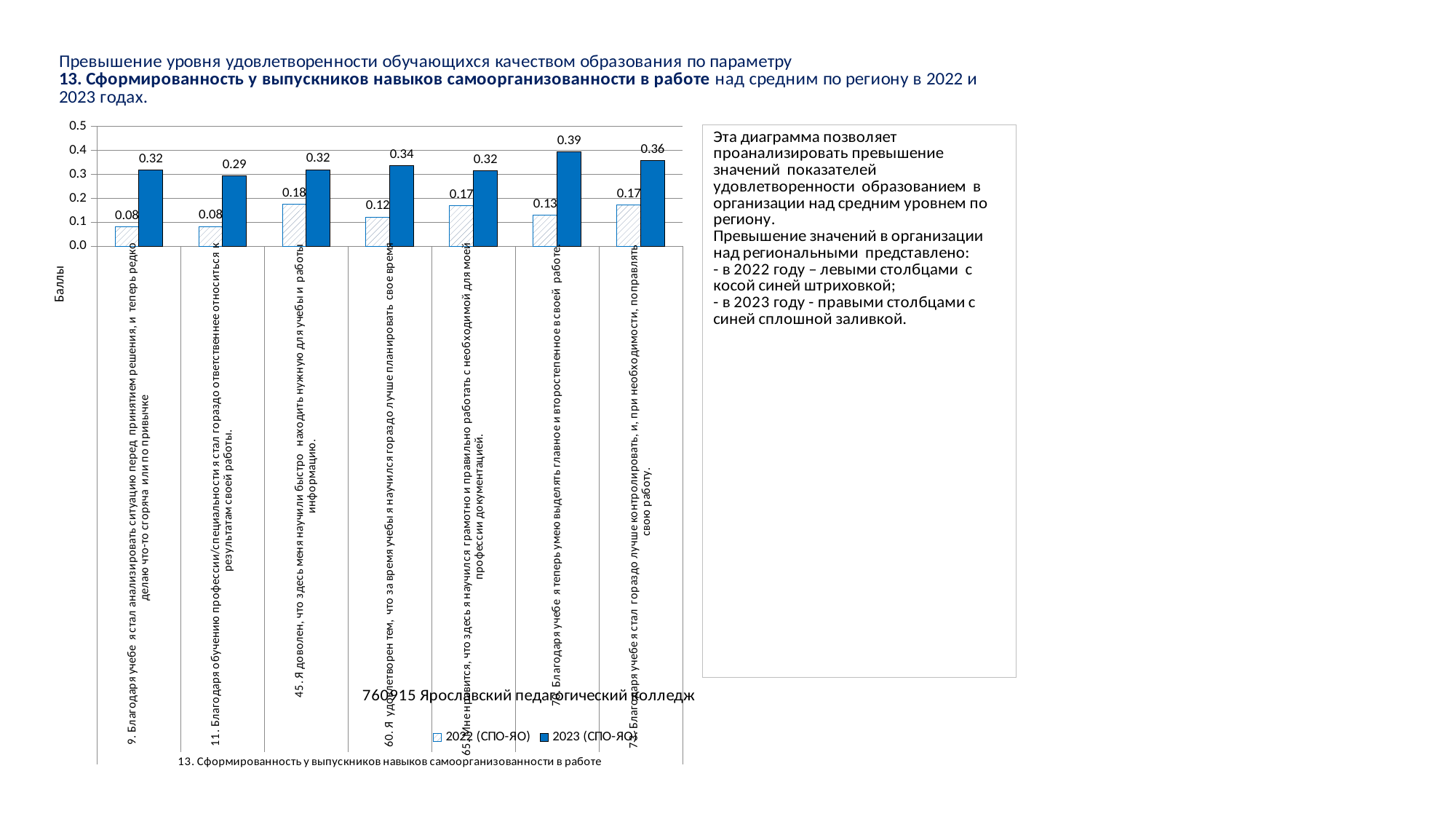
According to the legend, which series is drawn with solid blue fill? 2023 (СПО-ЯО) What is the 2023 (СПО-ЯО) value for statement 11 ("Благодаря обучению профессии/специальности я стал гораздо ответственнее относиться к результатам своей работы")? 0.29 What is the difference between the 2023 and 2022 values for statement 60 ("Я удовлетворен тем, что за время учебы я научился гораздо лучше планировать свое время")? 0.22 How many series does the legend list? 2 Is the 2023 (СПО-ЯО) value for statement 9 greater or less than 0.2? greater What kind of chart is shown on the slide? bar chart What is the 2022 (СПО-ЯО) value for statement 45 ("Я доволен, что здесь меня научили быстро находить нужную для учебы и работы информацию")? 0.18 Which statement has the highest 2023 (СПО-ЯО) value? 70. Благодаря учебе я теперь умею выделять главное и второстепенное в своей работе Which statement has the lowest 2023 (СПО-ЯО) value? 11. Благодаря обучению профессии/специальности я стал гораздо ответственнее относиться к результатам своей работы How many categories (statements) are plotted along the x axis? 7 What is the 2023 (СПО-ЯО) value for statement 70 ("Благодаря учебе я теперь умею выделять главное и второстепенное в своей работе")? 0.39